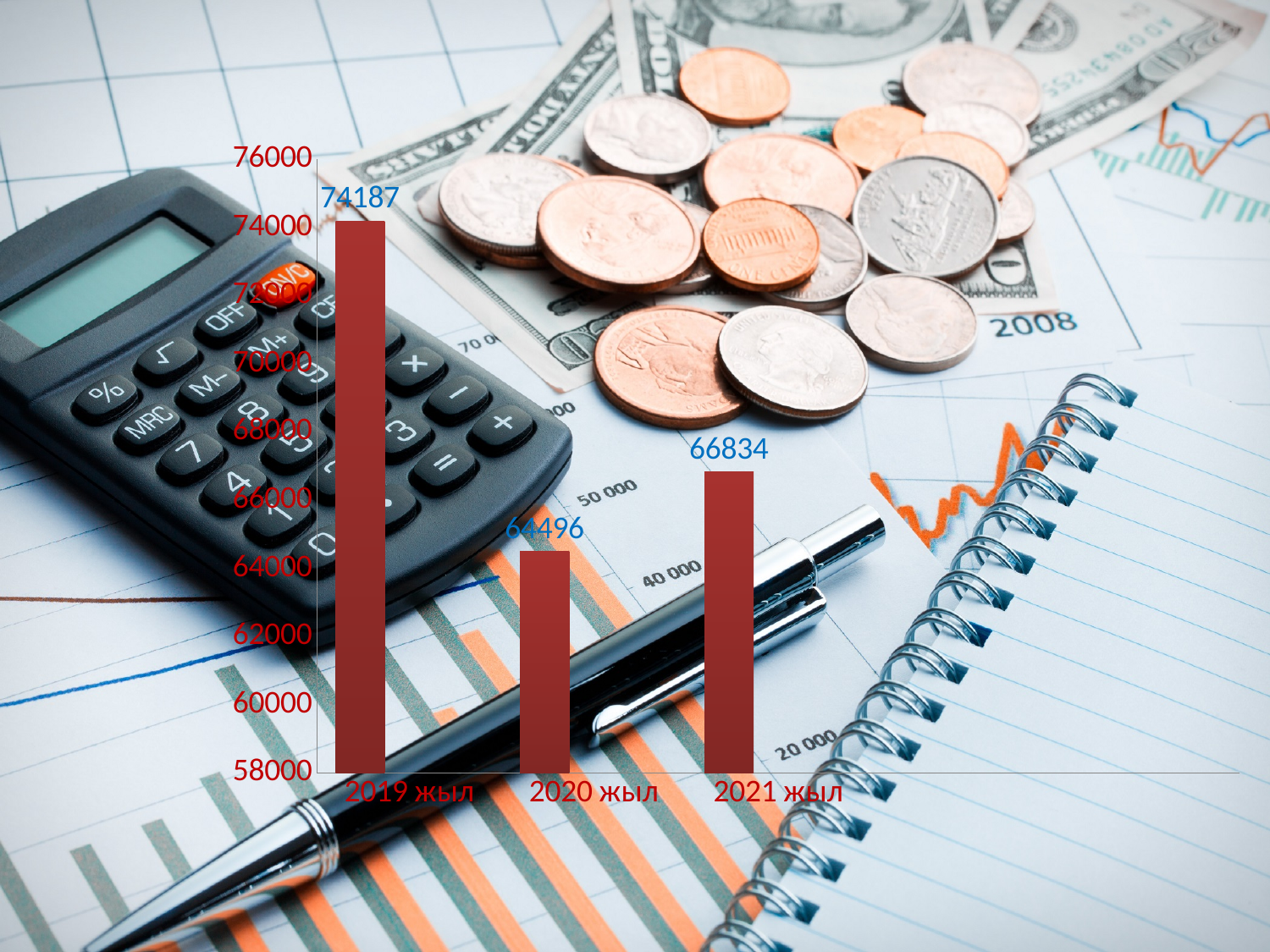
Does the value rise or fall from 2019 жыл to 2020 жыл? fall What is the value for 2020 жыл? 64496 What is the value for 2019 жыл? 74187 Which is larger, the value for 2020 жыл or 2021 жыл? 2021 жыл Is the value for 2021 жыл greater or less than 68000? less What is the difference between the values for 2019 жыл and 2020 жыл? 9691 Which year has the highest value? 2019 жыл How many bars are shown in the chart? 3 What is the difference between the values for 2021 жыл and 2020 жыл? 2338 What kind of chart is shown on the slide? bar chart Which year has the lowest value? 2020 жыл What is the value for 2021 жыл? 66834